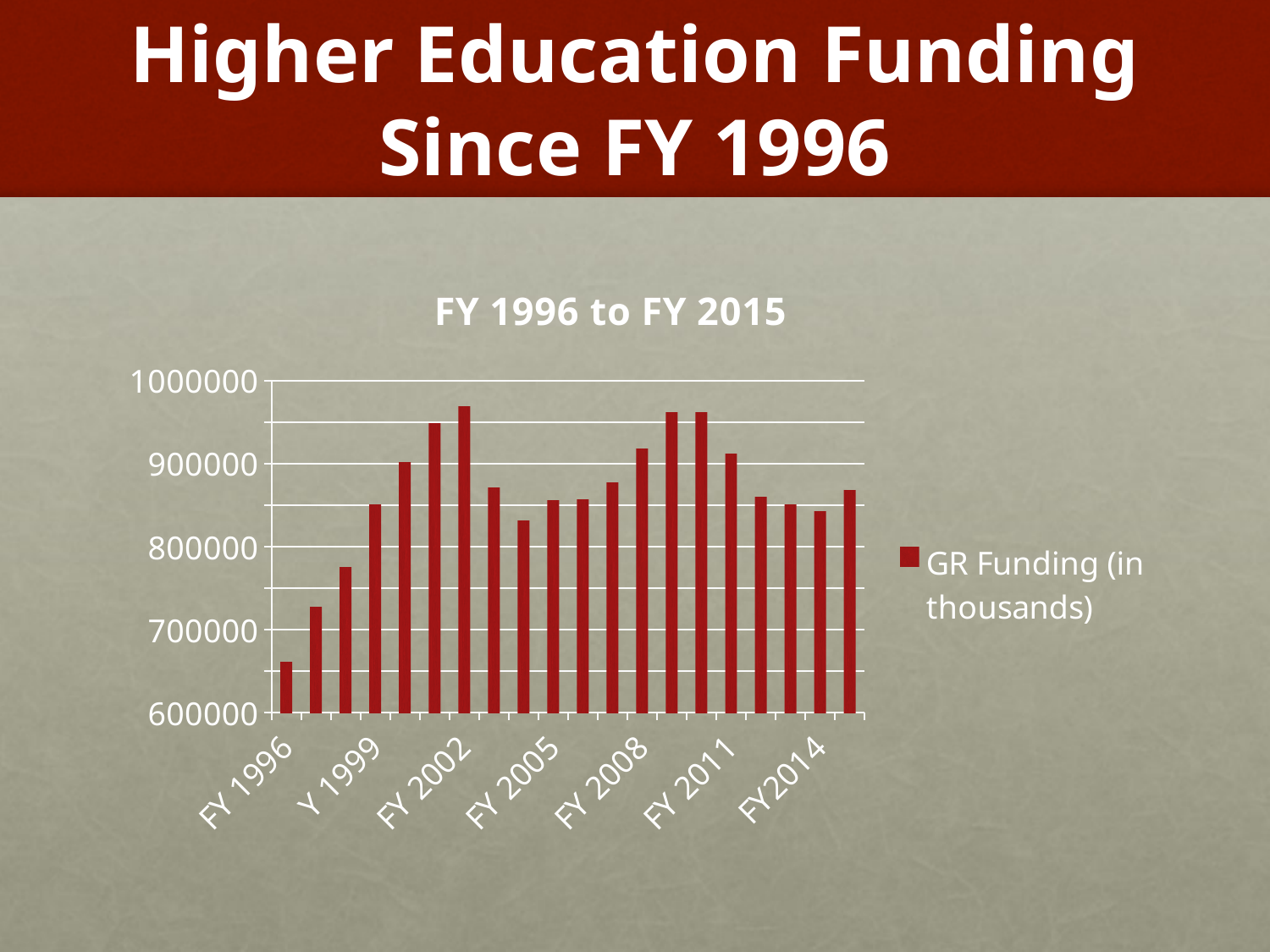
What is the title of the chart? FY 1996 to FY 2015 Do the values rise or fall from FY 1996 to FY 2002? rise How many series does the legend list? 1 What kind of chart is shown on the slide? bar chart What is the legend entry for the series in the chart? GR Funding (in thousands) Is the value for FY 2005 greater or less than 900000? less Which is larger, the value for FY 1996 or the value for FY 1999? FY 1999 How many bars are plotted in the chart? 20 Is the value for FY 2002 greater or less than 900000? greater Is the value for FY 1996 greater or less than 700000? less Which fiscal year has the lowest GR Funding value? FY 1996